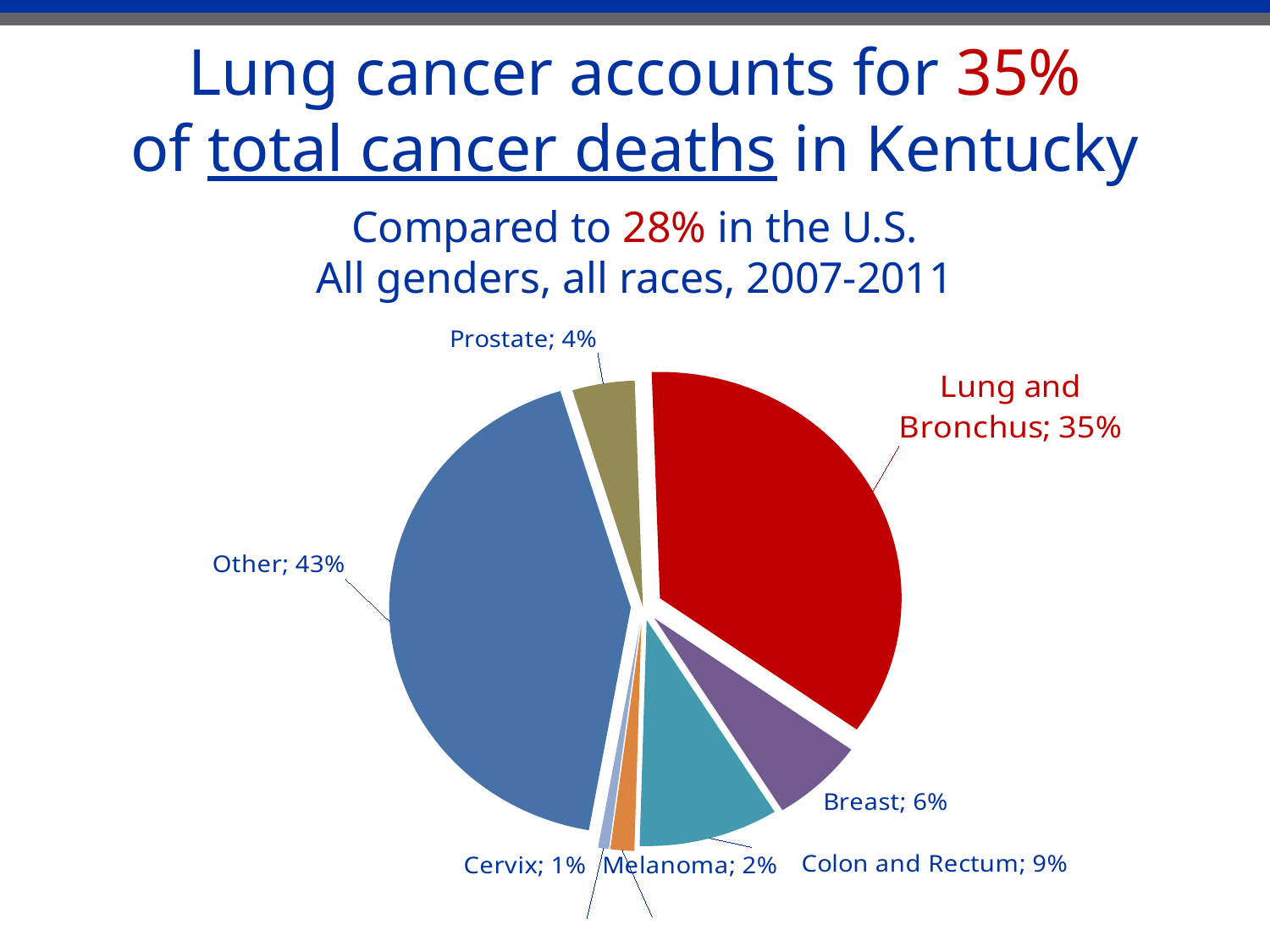
Which slice of the pie is the largest? Other What share of the pie does Lung and Bronchus account for? 35% What is the value for Cervix? 1% What colour is the Lung and Bronchus slice? Red What kind of chart is shown on the slide? Pie chart How many slices does the pie chart have? 7 What is the value shown for Colon and Rectum? 9% What is the difference between the Other slice and the Lung and Bronchus slice? 8% Which slice of the pie is the smallest? Cervix Which is larger, Breast or Colon and Rectum? Colon and Rectum What percentage is shown for Prostate? 4% What is the combined share of Breast and Melanoma? 8%